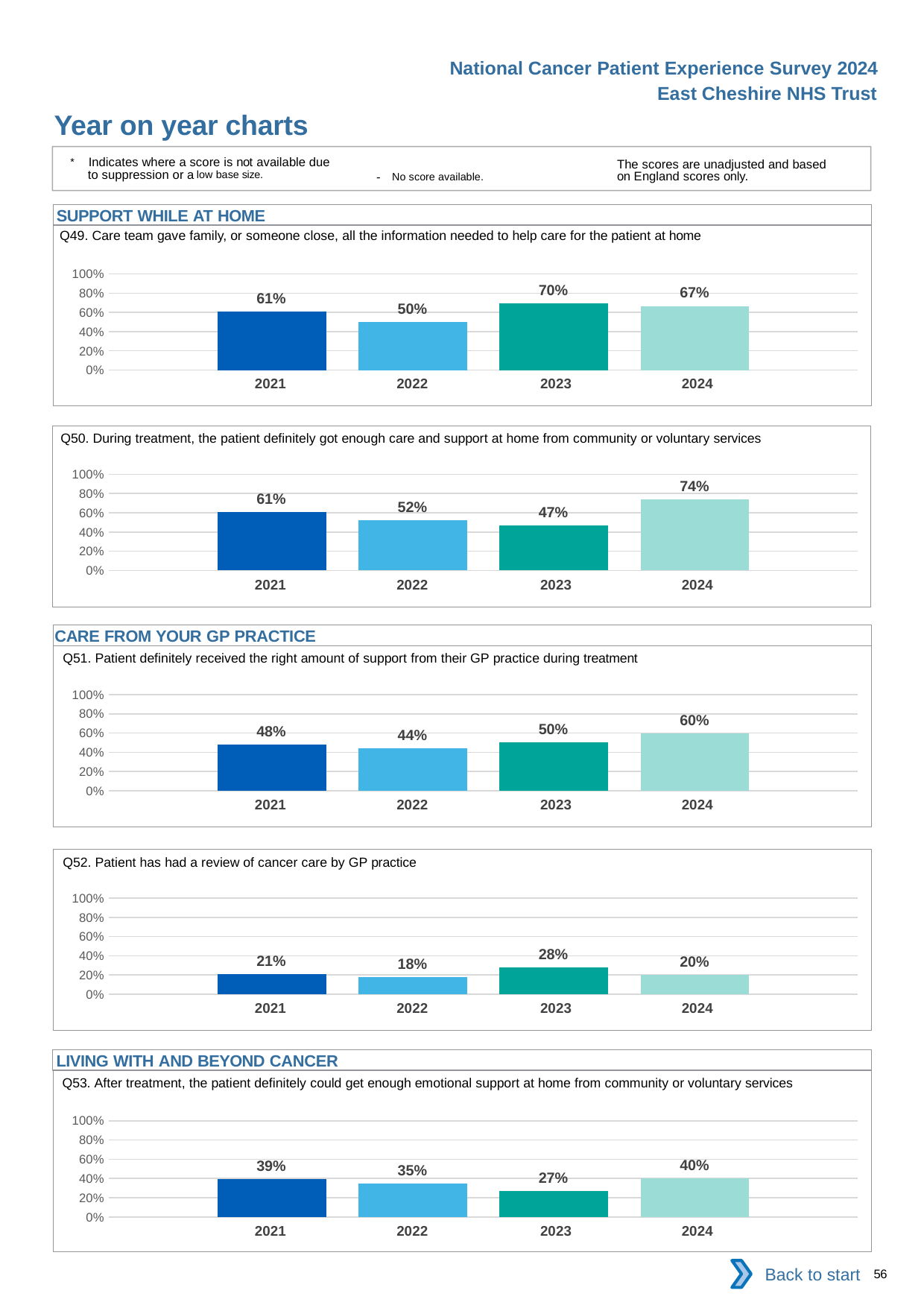
In the Q51 chart, what is the difference between the 2024 and 2021 values? 12% Which section heading appears above the Q53 chart? LIVING WITH AND BEYOND CANCER In the Q49 chart, what is the difference between the 2022 and 2021 values? 11% What kind of chart is the Q49 chart? Bar chart In the Q49 chart, what is the value for 2023? 70% How many years are shown in the Q52 chart? 4 In the Q51 chart, is the value for 2024 greater or less than 40%? greater In the Q50 chart, which year has the highest value? 2024 In the Q50 chart, which year has the lowest value? 2023 In the Q53 chart, what is the value for 2022? 35% In the Q52 chart, which is larger, the value for 2021 or the value for 2023? 2023 In the Q53 chart, which year has the lowest value? 2023